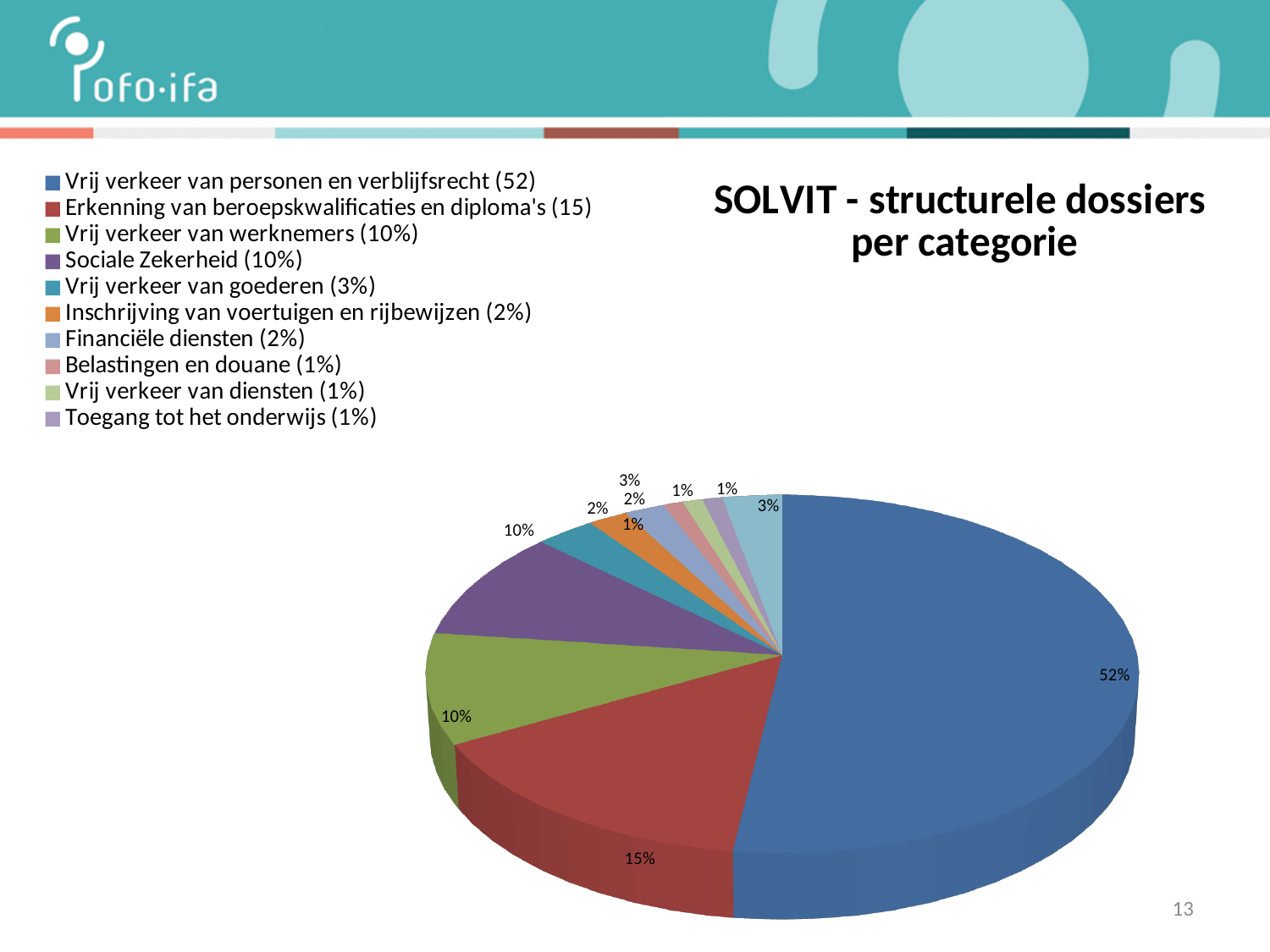
What is the title of the chart? SOLVIT - structurele dossiers per categorie What is the percentage for 'Financiële diensten'? 2% How many entries does the legend list? 10 What is the difference in percentage points between 'Vrij verkeer van personen en verblijfsrecht' and 'Erkenning van beroepskwalificaties en diploma's'? 37 percentage points What is the percentage for 'Vrij verkeer van werknemers'? 10% Which category has the largest slice of the pie? Vrij verkeer van personen en verblijfsrecht What percentage is shown for 'Erkenning van beroepskwalificaties en diploma's'? 15% What kind of chart is shown on the slide? Pie chart What is the percentage for 'Vrij verkeer van goederen'? 3% What share of the pie does 'Vrij verkeer van personen en verblijfsrecht' have? 52% What colour is the largest slice of the pie? Blue Which is larger: 'Sociale Zekerheid' or 'Vrij verkeer van goederen'? Sociale Zekerheid